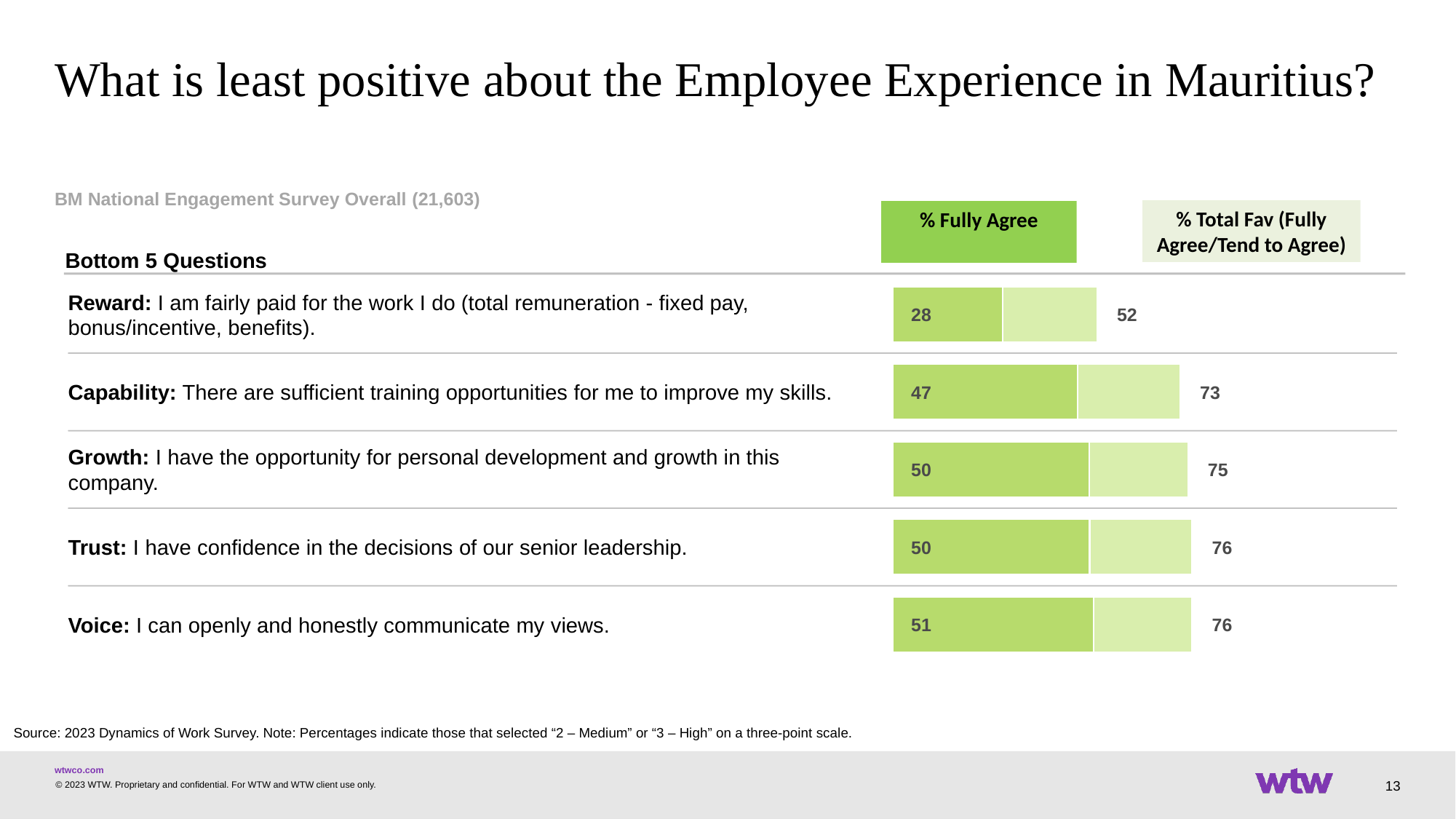
What is the % Total Fav value for Capability? 73 How many questions (categories) are plotted in the chart? 5 Which question has the highest % Fully Agree value? Voice What is the % Fully Agree value for Voice? 51 What is the label of the darker green series in the legend? % Fully Agree What is the % Fully Agree value for Reward? 28 What is the difference between the % Total Fav values for Trust and Reward? 24 What is the % Total Fav value for Growth? 75 What kind of chart is shown on the slide? bar chart Which question has the lowest % Fully Agree value? Reward How many series does the chart legend list? 2 Which has a larger % Total Fav value, Capability or Growth? Growth